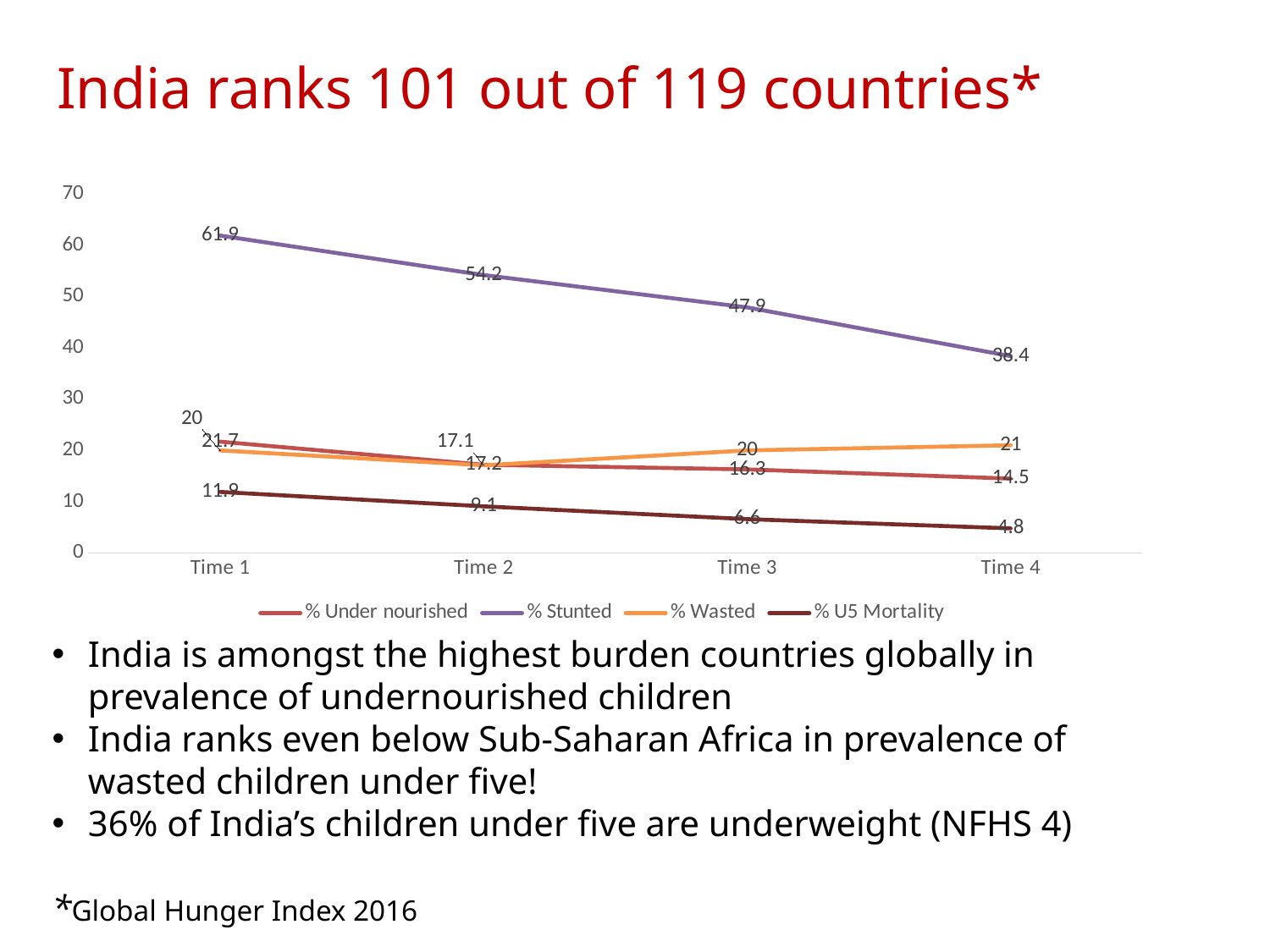
What is the value of % Under nourished at Time 4? 14.5 By how much did % Stunted fall from Time 1 to Time 4? 23.5 What is the value of % U5 Mortality at Time 4? 4.8 What is the value of % Wasted at Time 4? 21 How many time points are shown on the x axis? 4 What kind of chart is shown on the slide? Line chart Which series has the highest value at Time 1? % Stunted What is the value of % Stunted at Time 1? 61.9 Which series has the lowest value at Time 4? % U5 Mortality Does % Stunted rise or fall from Time 1 to Time 4? Fall How many series does the legend list? 4 What is the value of % Stunted at Time 4? 38.4